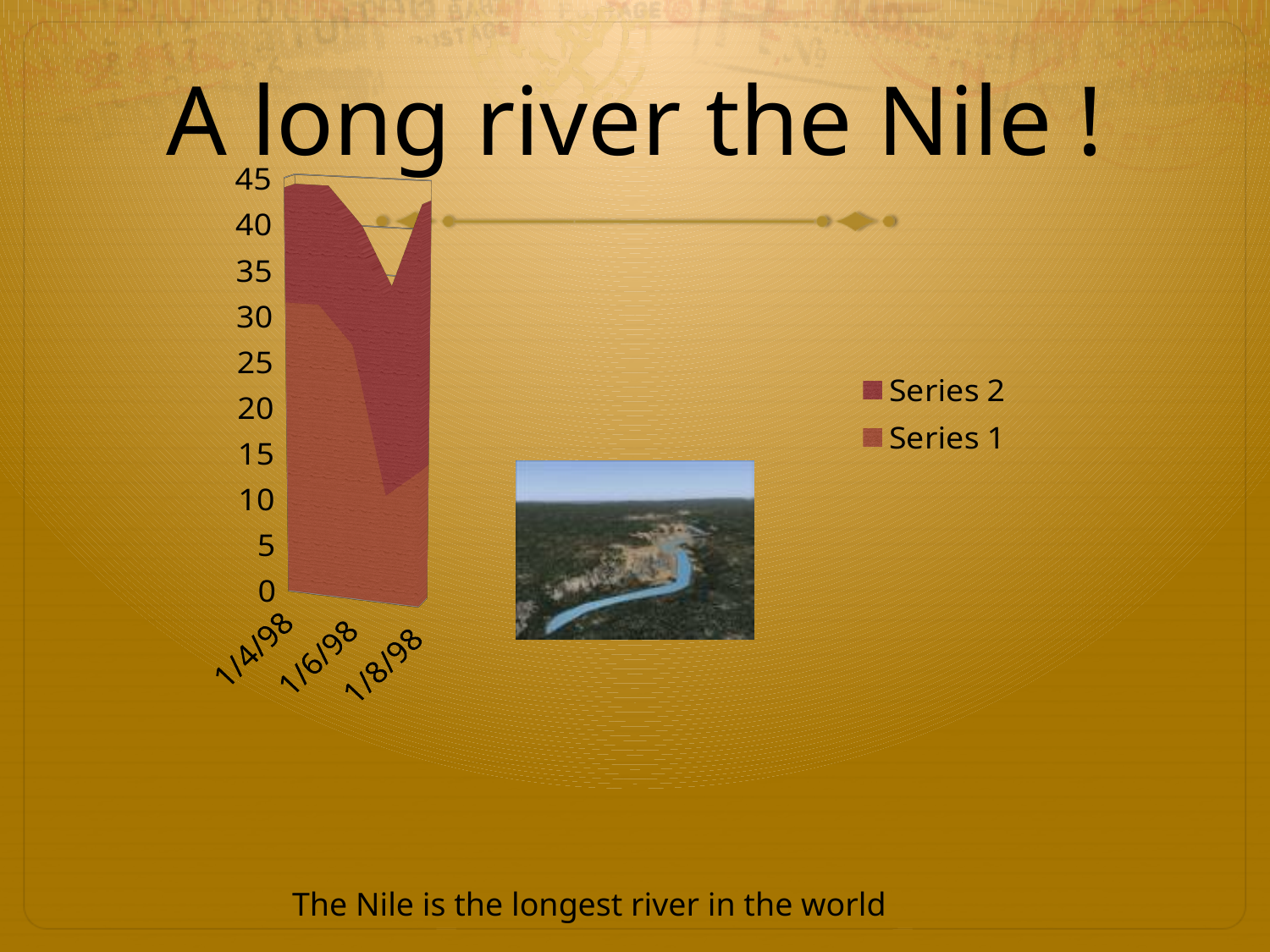
What is the title of the slide containing the chart? A long river the Nile ! What are the two entries listed in the chart's legend? Series 2 and Series 1 What kind of chart is shown on the slide? area chart Which category has the highest value for Series 1? 1/4/98 Which is larger for Series 1: the value at 1/4/98 or the value at 1/6/98? 1/4/98 Is the value for Series 1 at 1/4/98 greater or less than 25? greater Is the stacked total at 1/4/98 greater or less than 40? greater Which category has the lowest stacked total (Series 1 plus Series 2)? 1/6/98 How many categories are shown on the x axis of the chart? 3 How many series does the chart's legend list? 2